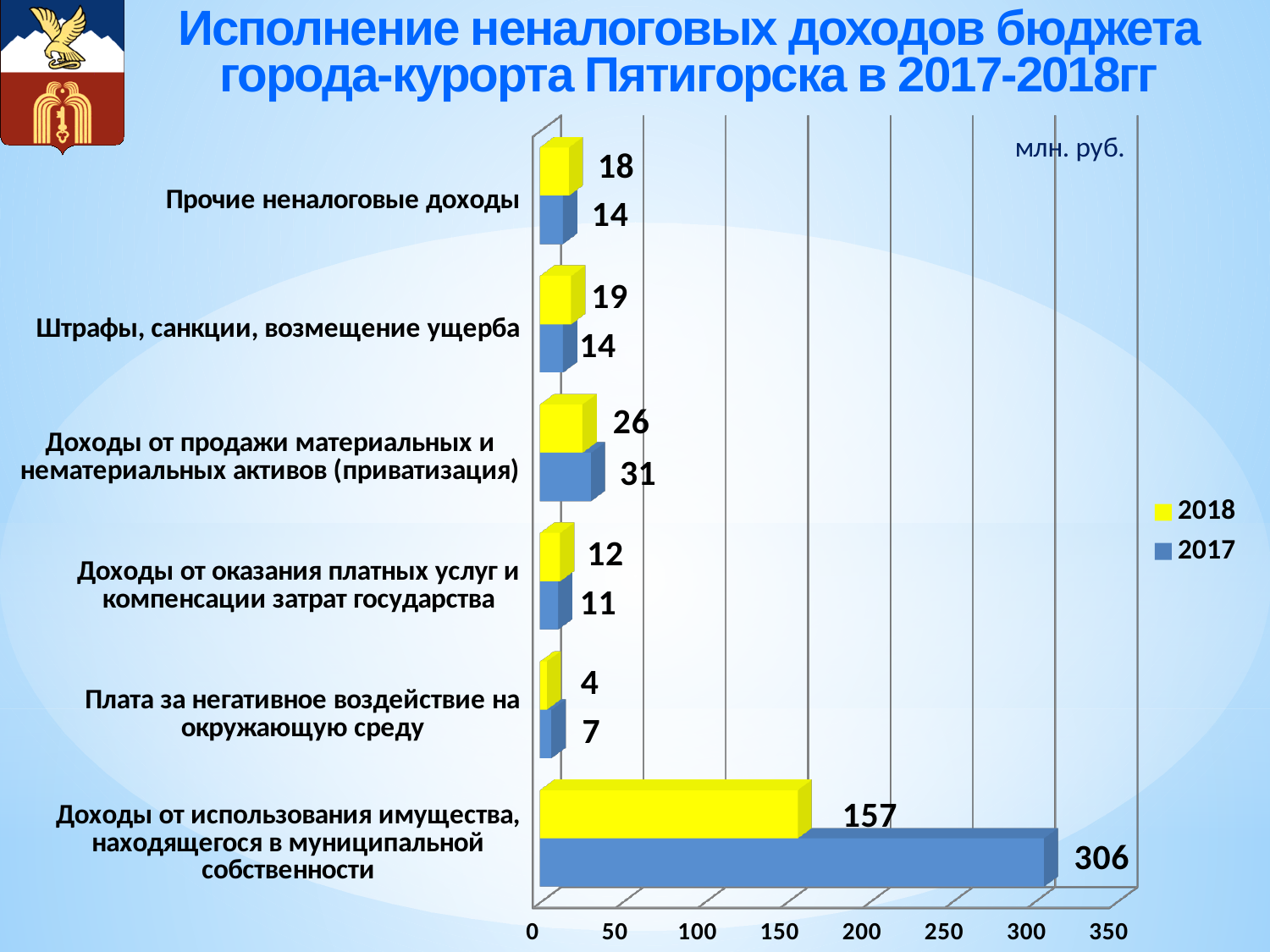
For 'Плата за негативное воздействие на окружающую среду', which year had the larger value, 2017 or 2018? 2017 Is the 2018 value for 'Доходы от использования имущества, находящегося в муниципальной собственности' greater or less than 150? greater How many categories are shown on the chart? 6 What was the 2017 value for 'Доходы от продажи материальных и нематериальных активов (приватизация)'? 31 What was the 2018 value for 'Штрафы, санкции, возмещение ущерба'? 19 What is the difference between the 2017 and 2018 values for 'Доходы от использования имущества, находящегося в муниципальной собственности'? 149 Which category has the highest 2017 value? Доходы от использования имущества, находящегося в муниципальной собственности What was the 2017 value for 'Доходы от использования имущества, находящегося в муниципальной собственности'? 306 What kind of chart is shown on the slide? Bar chart How many series does the legend list? 2 For 'Прочие неналоговые доходы', which year had the larger value, 2017 or 2018? 2018 Which category has the lowest 2018 value? Плата за негативное воздействие на окружающую среду